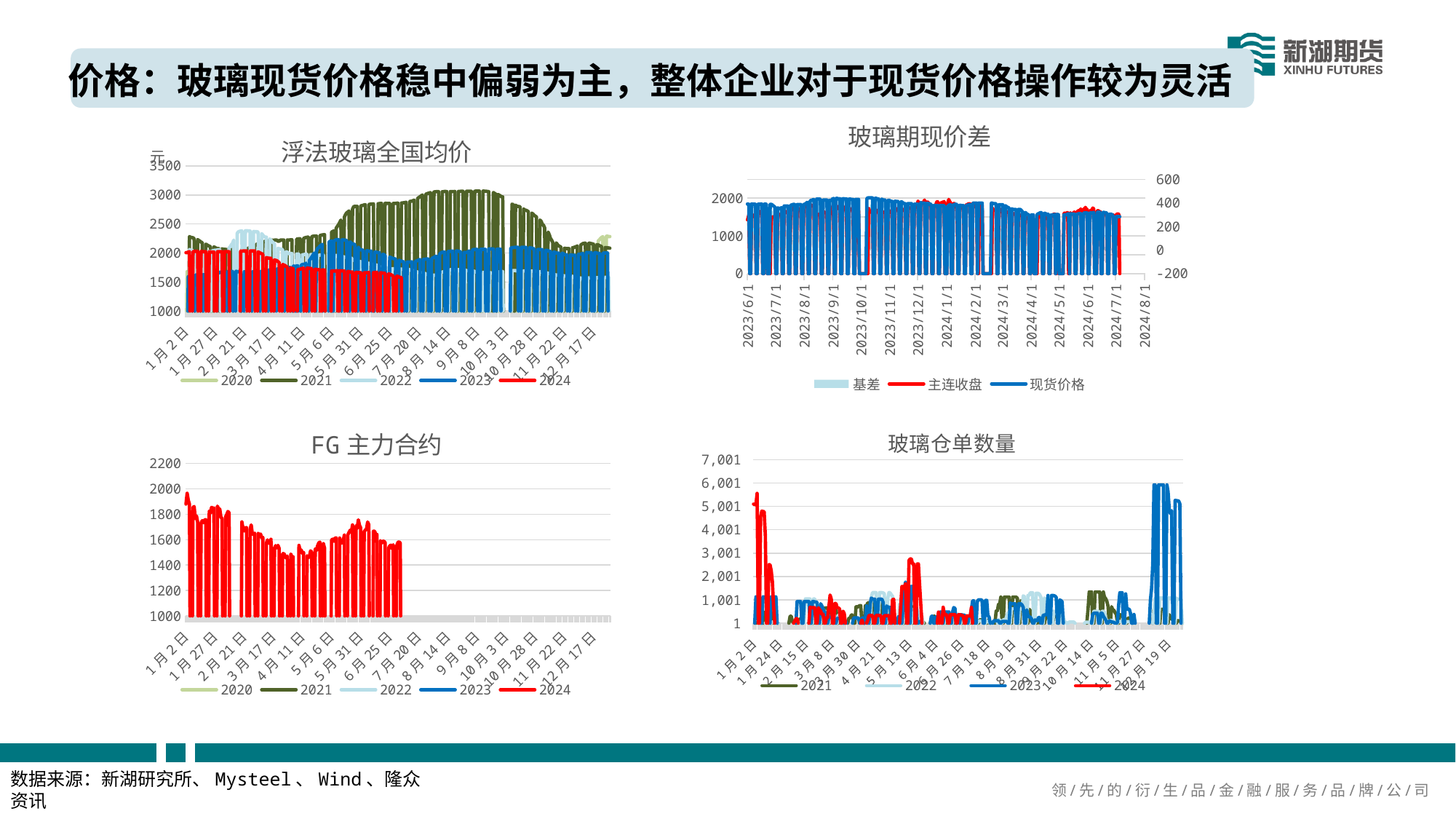
How many series does the legend of the 玻璃仓单数量 chart list? 4 In the FG 主力合约 chart, does the 2024 series overall rise or fall from 1月2日 to its last plotted point? fall In the 浮法玻璃全国均价 chart, is the peak of the 2021 series greater or less than 2500? greater How many series does the legend of the 玻璃期现价差 chart list? 3 In the 浮法玻璃全国均价 chart, is the highest value of the 2024 series greater or less than 2500? less How many series does the legend of the 浮法玻璃全国均价 chart list? 5 In the 玻璃仓单数量 chart, is the peak of the 2023 series greater or less than 5,001? greater In the 浮法玻璃全国均价 chart, which year's series reaches the highest value? 2021 In the 玻璃仓单数量 chart, which year's series reaches the highest value? 2023 What kind of chart is the FG 主力合约 chart? line chart What is the title of the chart in the top-right of the slide? 玻璃期现价差